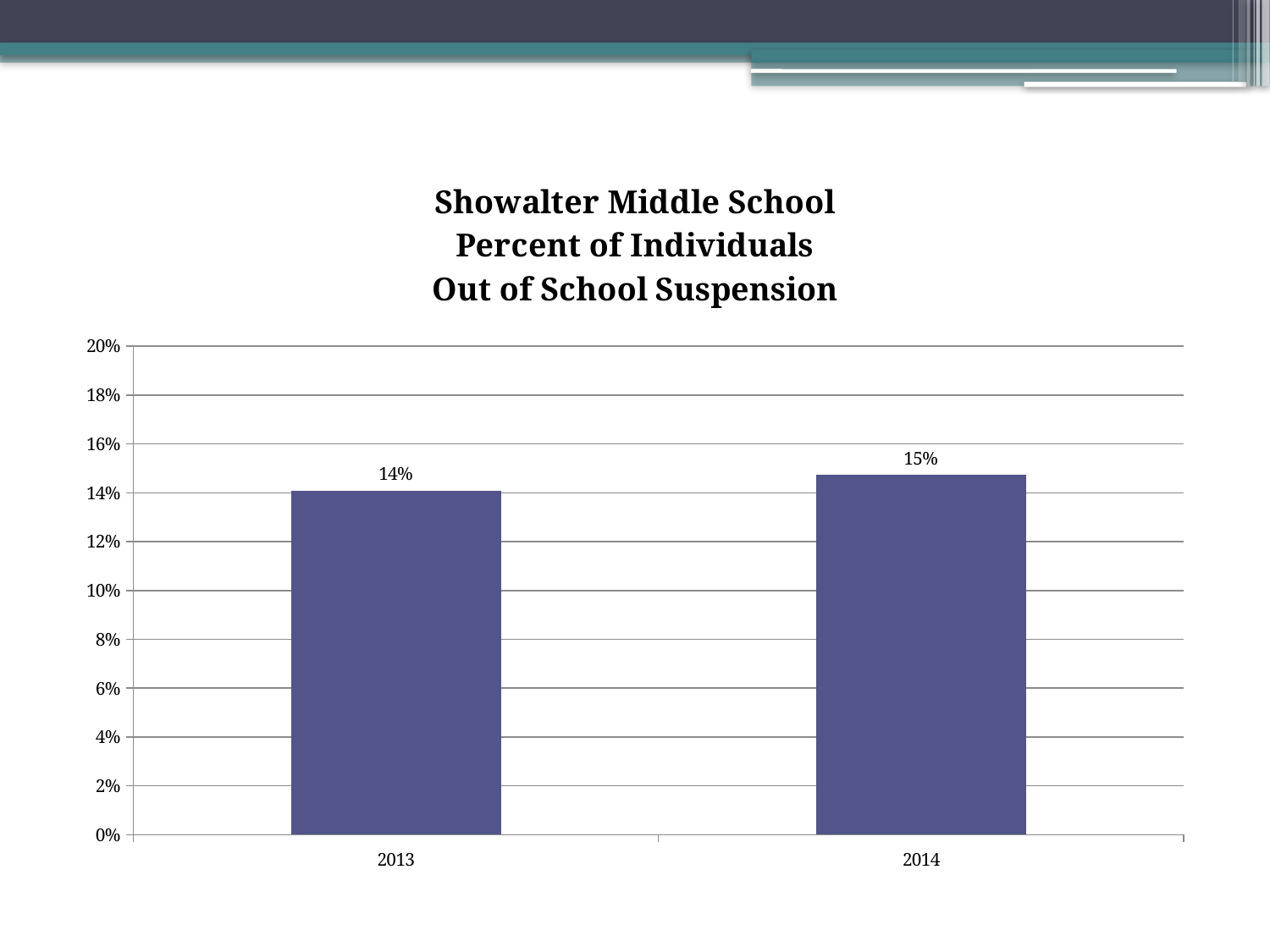
Which year has the lower percent of individuals with out of school suspension? 2013 What is the title of the chart? Showalter Middle School Percent of Individuals Out of School Suspension What kind of chart is shown on the slide? bar chart Do the values rise or fall from 2013 to 2014? rise Which year has the higher percent of individuals with out of school suspension? 2014 What is the value for 2013? 14% Is the value for 2013 greater or less than 10%? greater What is the value for 2014? 15% Is the value for 2014 greater or less than 16%? less What is the maximum value shown on the y axis? 20% What is the difference between the 2014 and 2013 values? 1% How many years are shown on the x axis? 2